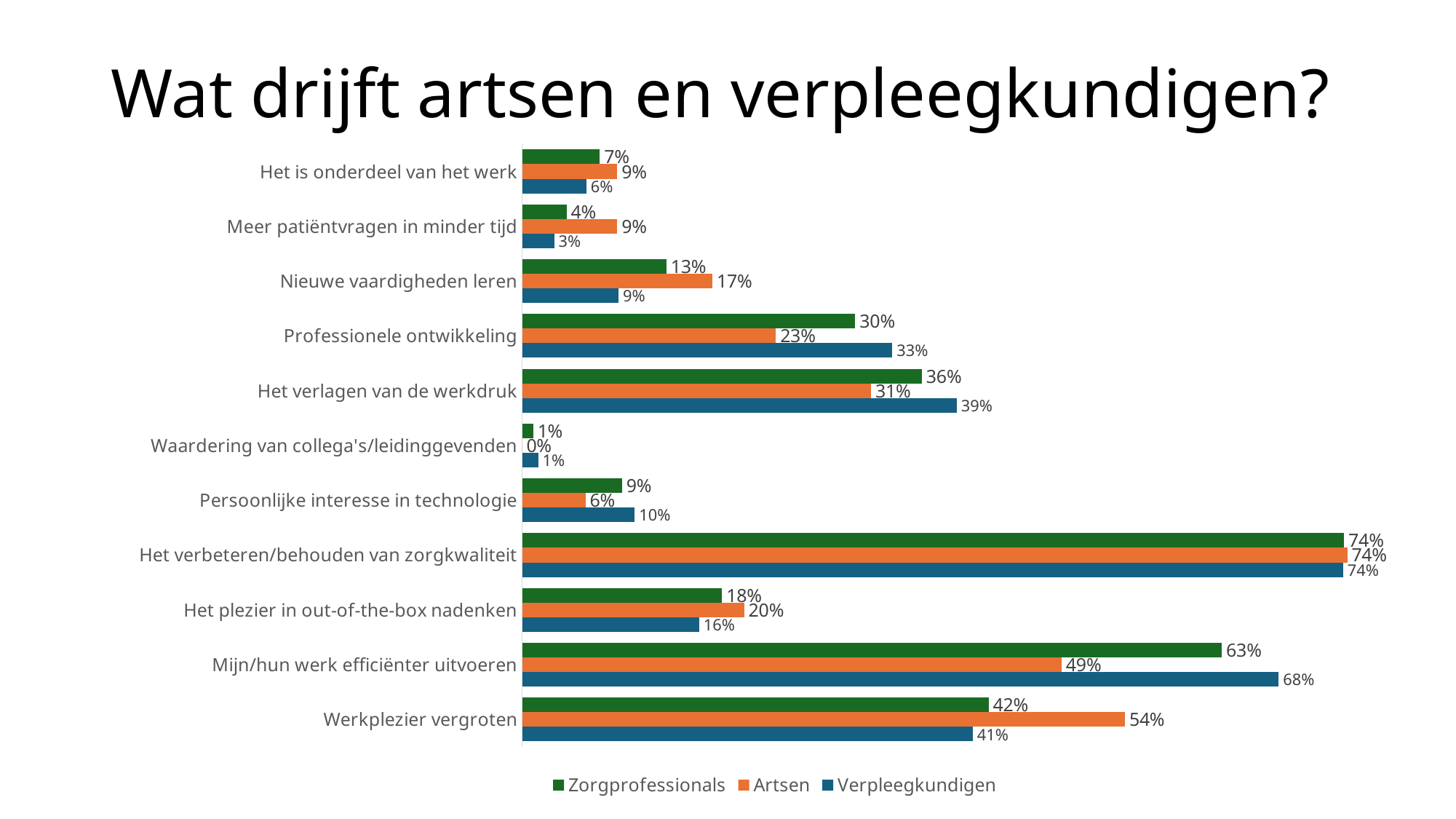
How many categories are shown on the y axis? 11 What kind of chart is shown on the slide? Bar chart Which category has the highest value for Artsen? Het verbeteren/behouden van zorgkwaliteit How many series does the legend list? 3 Which series is shown in orange in the legend? Artsen What is the value for Verpleegkundigen for 'Mijn/hun werk efficiënter uitvoeren'? 68% What is the value for Artsen for 'Waardering van collega's/leidinggevenden'? 0% What is the difference between the Zorgprofessionals and Artsen values for 'Mijn/hun werk efficiënter uitvoeren'? 14% What is the value for Artsen for 'Werkplezier vergroten'? 54% Which category has the lowest value for Verpleegkundigen? Waardering van collega's/leidinggevenden What is the value for Zorgprofessionals for 'Professionele ontwikkeling'? 30% For 'Werkplezier vergroten', which is larger: the Artsen value or the Verpleegkundigen value? Artsen